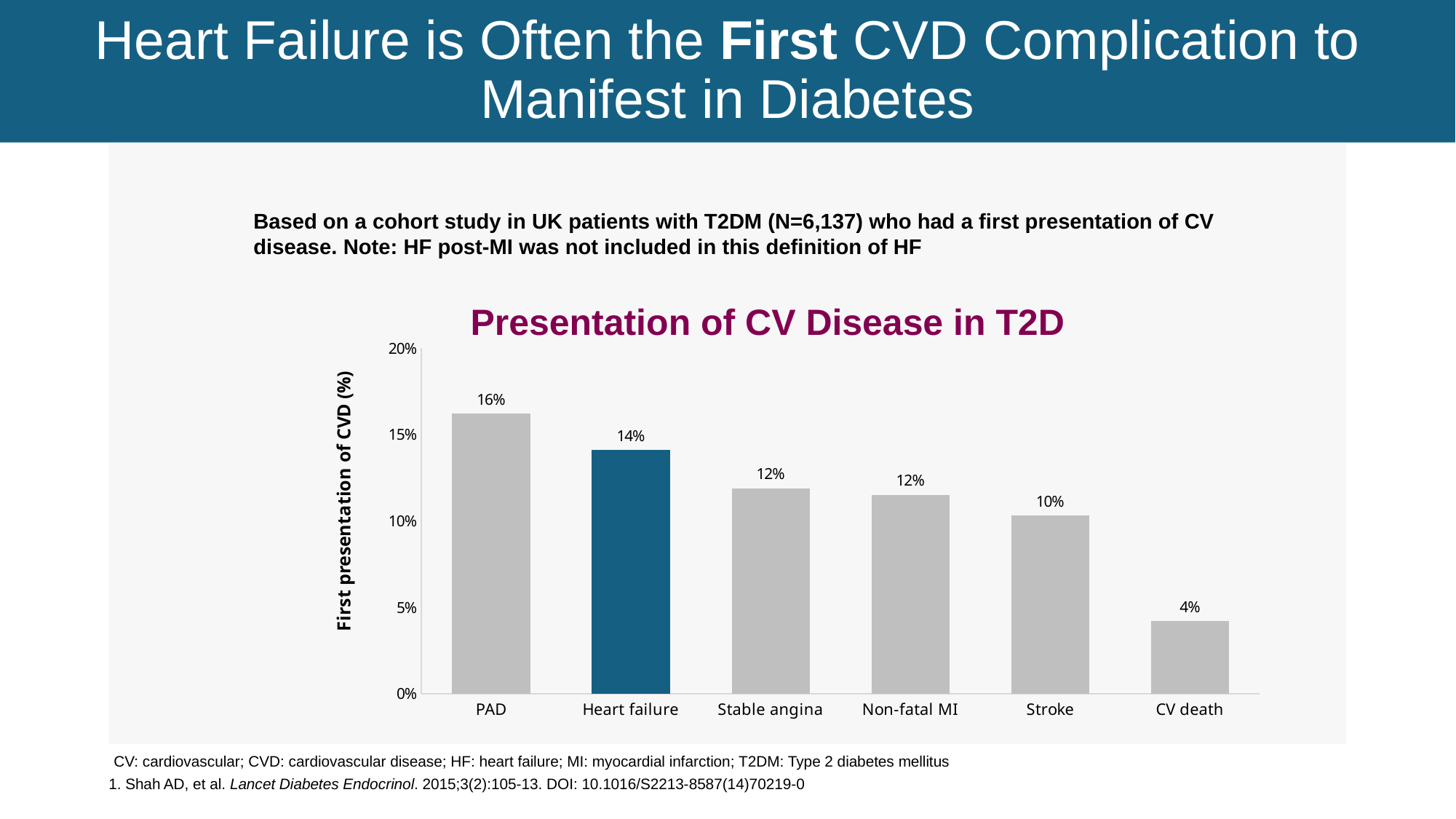
Which category has the highest value? PAD Which is larger, the value for Heart failure or the value for Stroke? Heart failure How many categories are shown on the x axis? 6 What is the difference between the values for PAD and Heart failure? 2% Is the value for Stable angina greater or less than 10%? greater What is the value for Heart failure? 14% What is the value for PAD? 16% What is the title of the chart? Presentation of CV Disease in T2D What is the value for Stroke? 10% Which category has the lowest value? CV death What kind of chart is shown? Bar chart What is the value for CV death? 4%